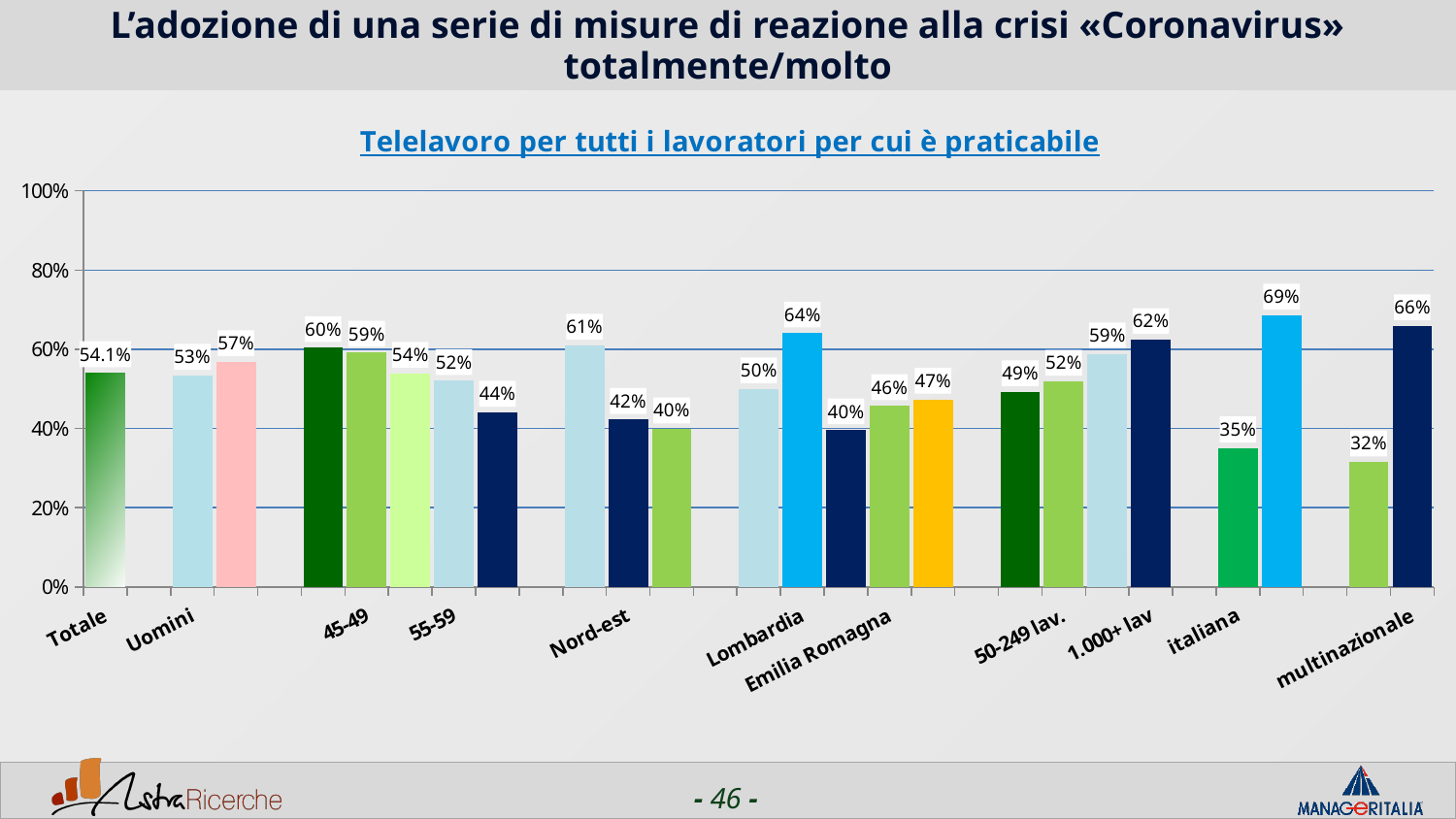
What is the value for Uomini? 53% What is the highest value shown on the chart? 69% What is the value for Totale? 54.1% What is the value for Lombardia? 64% What is the lowest value shown on the chart? 32% Is the value for Totale greater or less than 60%? less What is the title of the chart? Telelavoro per tutti i lavoratori per cui è praticabile What is the difference between the value for Lombardia and the value for Totale? 9.9% Which is larger, the value for Totale or the value for Uomini? Totale Is the value for Lombardia greater or less than 60%? greater How many bars are plotted on the chart? 24 What kind of chart is shown on the slide? bar chart